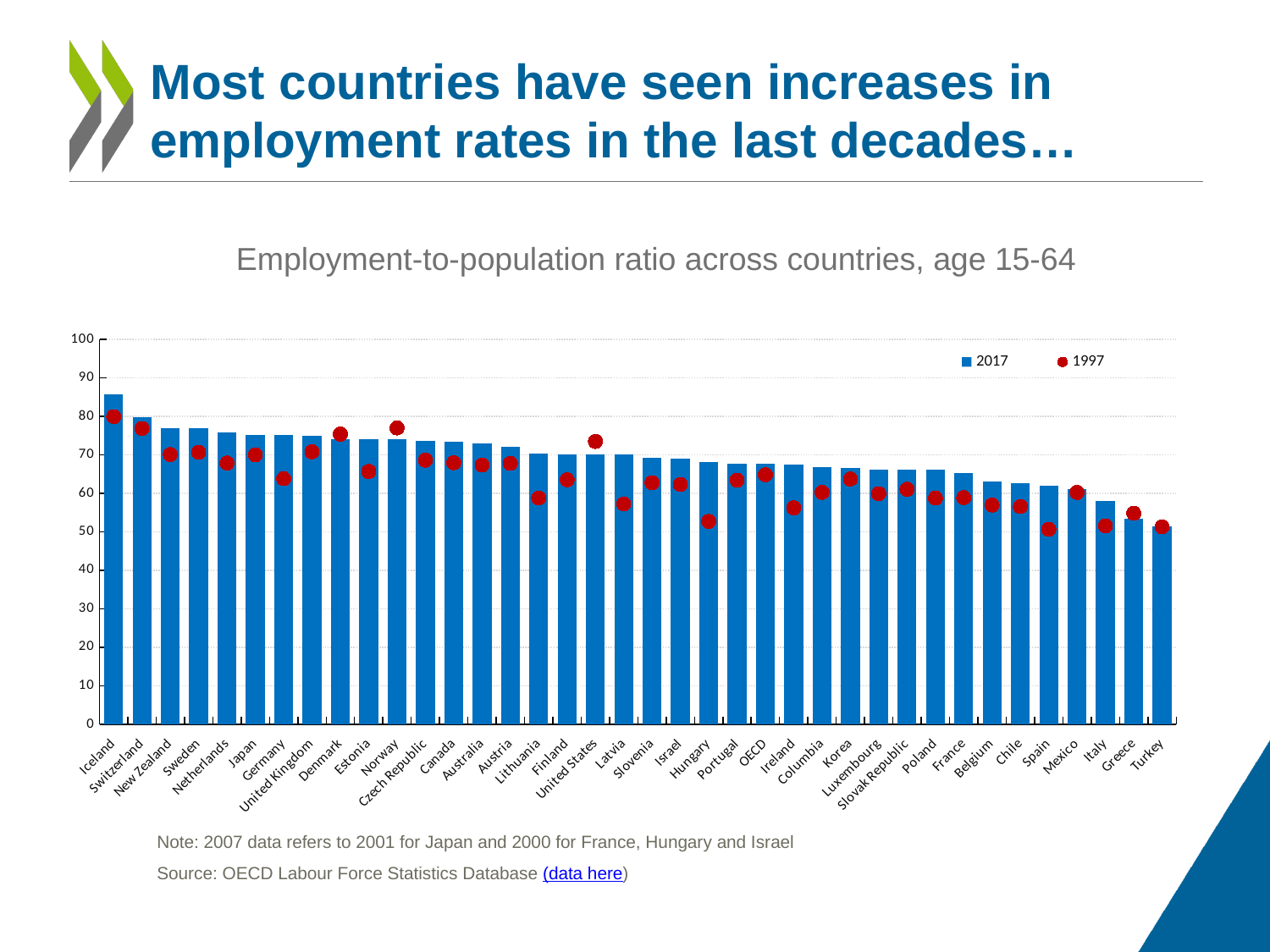
Is the 1997 value for Norway greater or less than 70? greater Which two series are listed in the legend? 2017 and 1997 Which has the larger 2017 value, Iceland or Greece? Iceland Which country has the lowest 2017 employment-to-population ratio? Turkey Do the 2017 bars rise or fall moving from left to right along the x axis? fall How many categories (countries and aggregates) are shown on the x axis? 38 Is the 1997 value for Hungary greater or less than 60? less Is the 2017 value for Iceland greater or less than 80? greater Which country has the highest 2017 employment-to-population ratio? Iceland What kind of chart is shown on the slide? Bar chart How many series does the legend list? 2